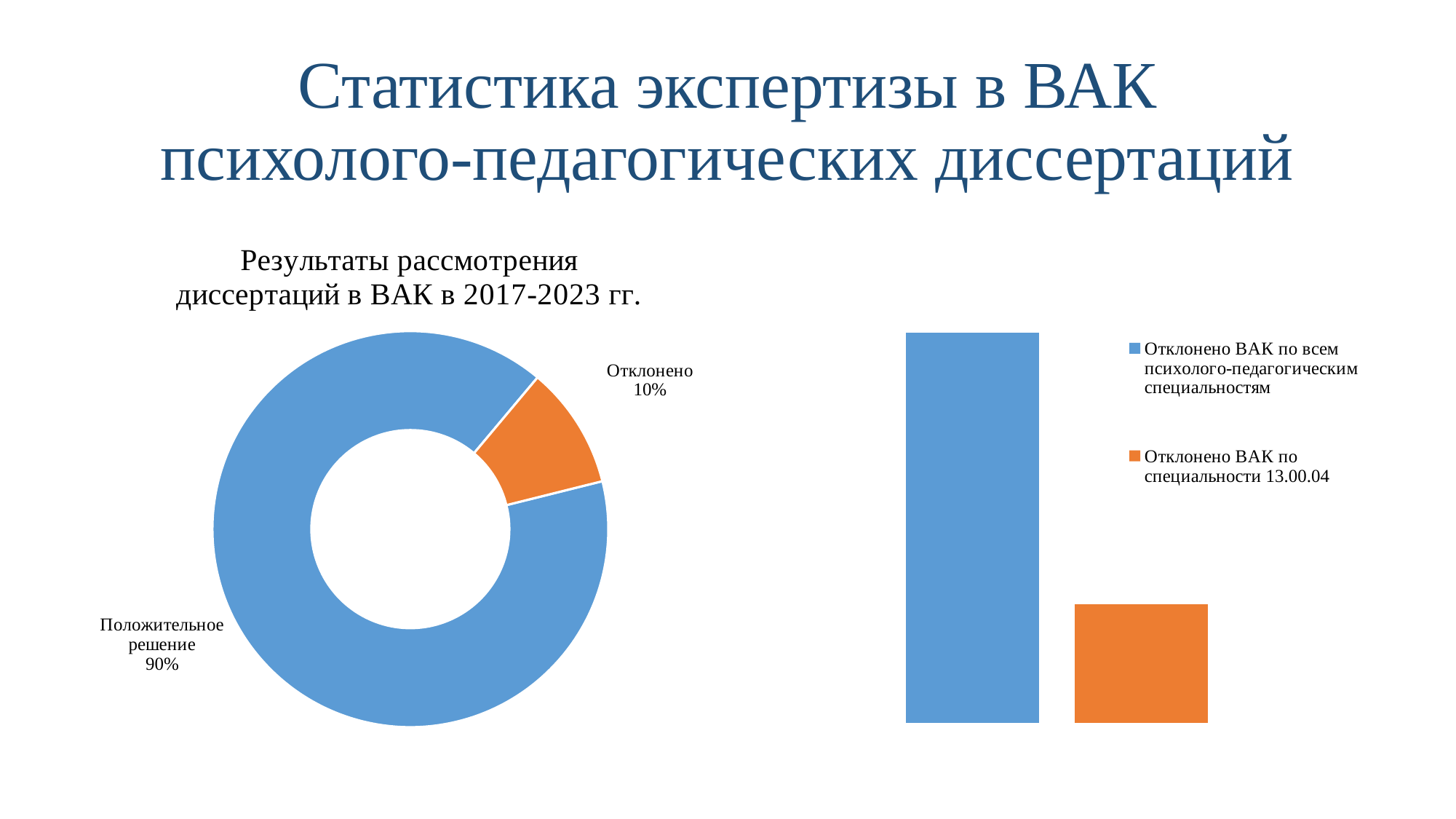
What kind of chart is the one titled "Результаты рассмотрения диссертаций в ВАК в 2017-2023 гг."? Doughnut (pie) chart In the chart titled "Результаты рассмотрения диссертаций в ВАК в 2017-2023 гг.", what colour is the "Отклонено" slice? Orange In the chart titled "Результаты рассмотрения диссертаций в ВАК в 2017-2023 гг.", what share is labelled "Отклонено"? 10% In the bar chart on the right side of the slide, how many entries does the legend list? 2 In the chart titled "Результаты рассмотрения диссертаций в ВАК в 2017-2023 гг.", what is the difference in percentage points between "Положительное решение" and "Отклонено"? 80 percentage points In the bar chart on the right side of the slide, what colour is the bar for "Отклонено ВАК по специальности 13.00.04"? Orange In the chart titled "Результаты рассмотрения диссертаций в ВАК в 2017-2023 гг.", how many categories are shown? 2 In the bar chart on the right side of the slide, which bar is taller: "Отклонено ВАК по всем психолого-педагогическим специальностям" or "Отклонено ВАК по специальности 13.00.04"? Отклонено ВАК по всем психолого-педагогическим специальностям In the chart titled "Результаты рассмотрения диссертаций в ВАК в 2017-2023 гг.", which category has the smallest share? Отклонено In the chart titled "Результаты рассмотрения диссертаций в ВАК в 2017-2023 гг.", which category has the largest share? Положительное решение What kind of chart is the one on the right side of the slide? Bar chart In the chart titled "Результаты рассмотрения диссертаций в ВАК в 2017-2023 гг.", what share is labelled "Положительное решение"? 90%